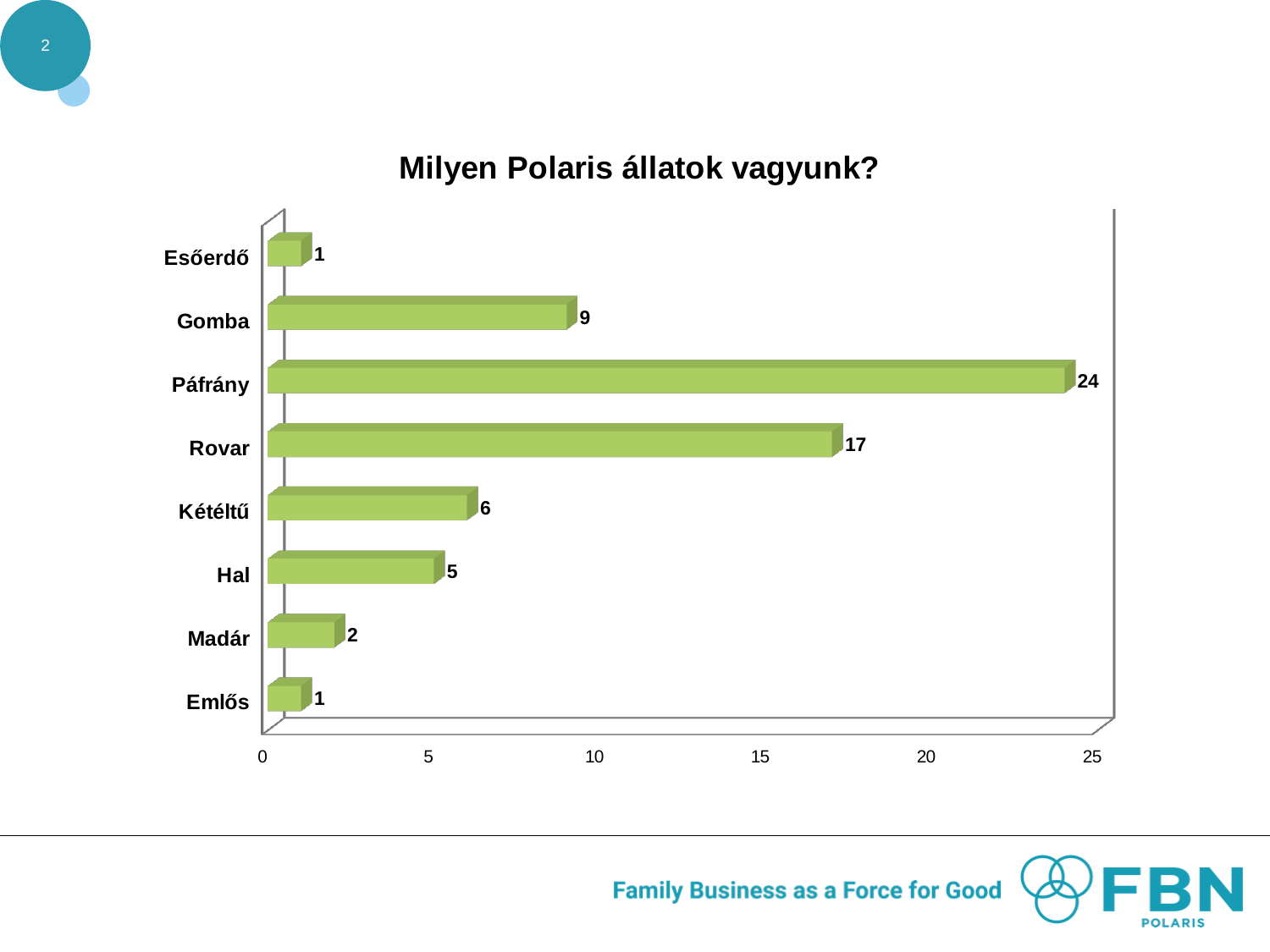
What is the title of the chart? Milyen Polaris állatok vagyunk? What kind of chart is shown on the slide? Bar chart What is the value for Rovar? 17 What is the value for Páfrány? 24 What is the value for Hal? 5 Is the value for Rovar greater or less than 15? greater What is the difference between the values for Páfrány and Rovar? 7 Which category has the highest value? Páfrány What is the value for Gomba? 9 Which is larger, the value for Gomba or the value for Kétéltű? Gomba What is the difference between the values for Kétéltű and Madár? 4 How many categories are shown in the chart? 8